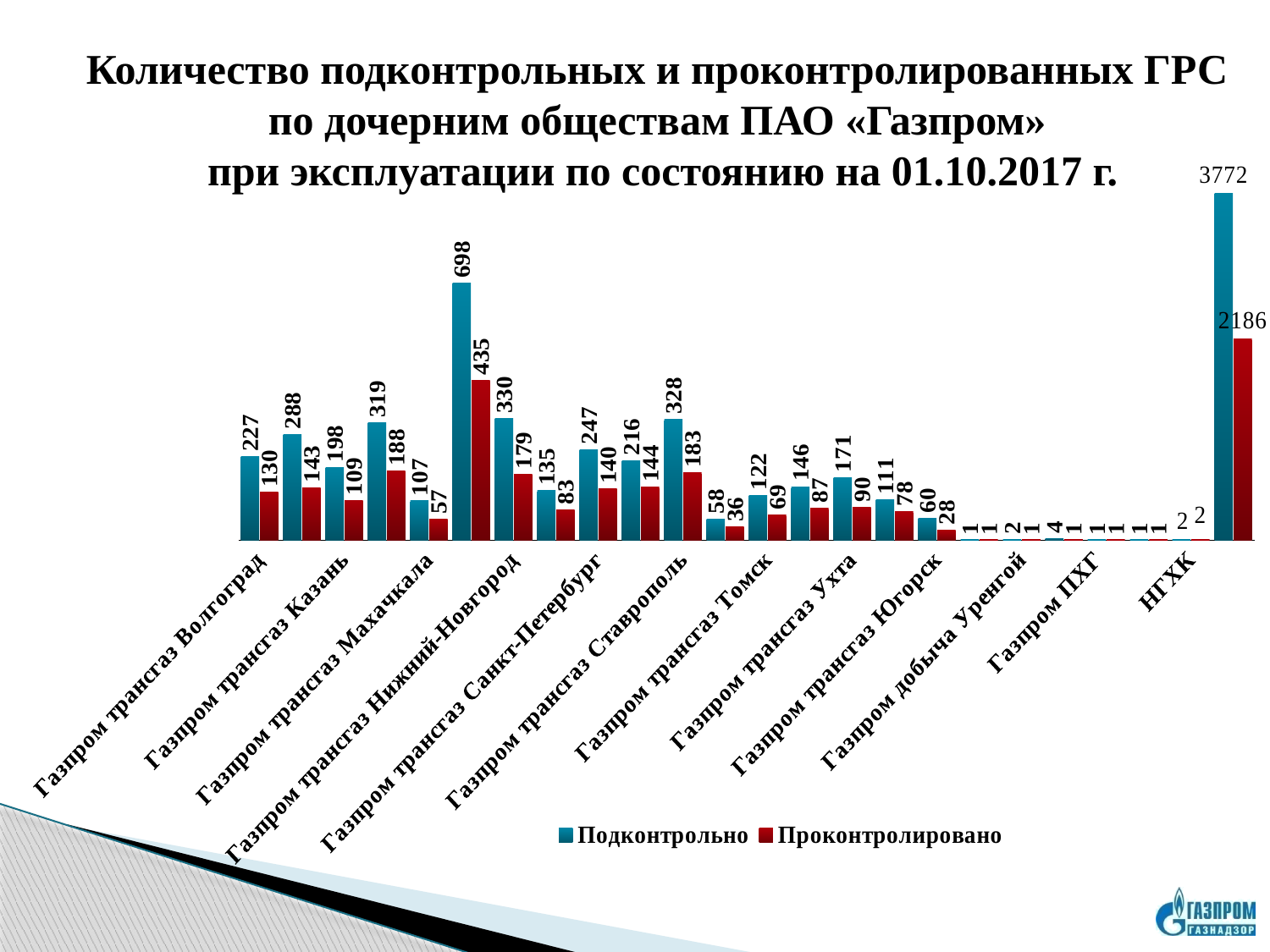
How many series does the legend list? 2 What is the Подконтрольно value for Газпром трансгаз Югорск? 60 For Газпром трансгаз Волгоград, which is larger: Подконтрольно or Проконтролировано? Подконтрольно What is the Подконтрольно value for Газпром трансгаз Волгоград? 227 What is the highest value shown for the Проконтролировано series? 2186 What is the Проконтролировано value for Газпром трансгаз Ставрополь? 183 What kind of chart is shown on the slide? bar chart What is the highest value shown for the Подконтрольно series? 3772 What are the two series named in the legend? Подконтрольно, Проконтролировано What is the Подконтрольно value for Газпром трансгаз Казань? 198 What is the difference between the Подконтрольно and Проконтролировано values for Газпром трансгаз Волгоград? 97 What is the Проконтролировано value for Газпром трансгаз Волгоград? 130